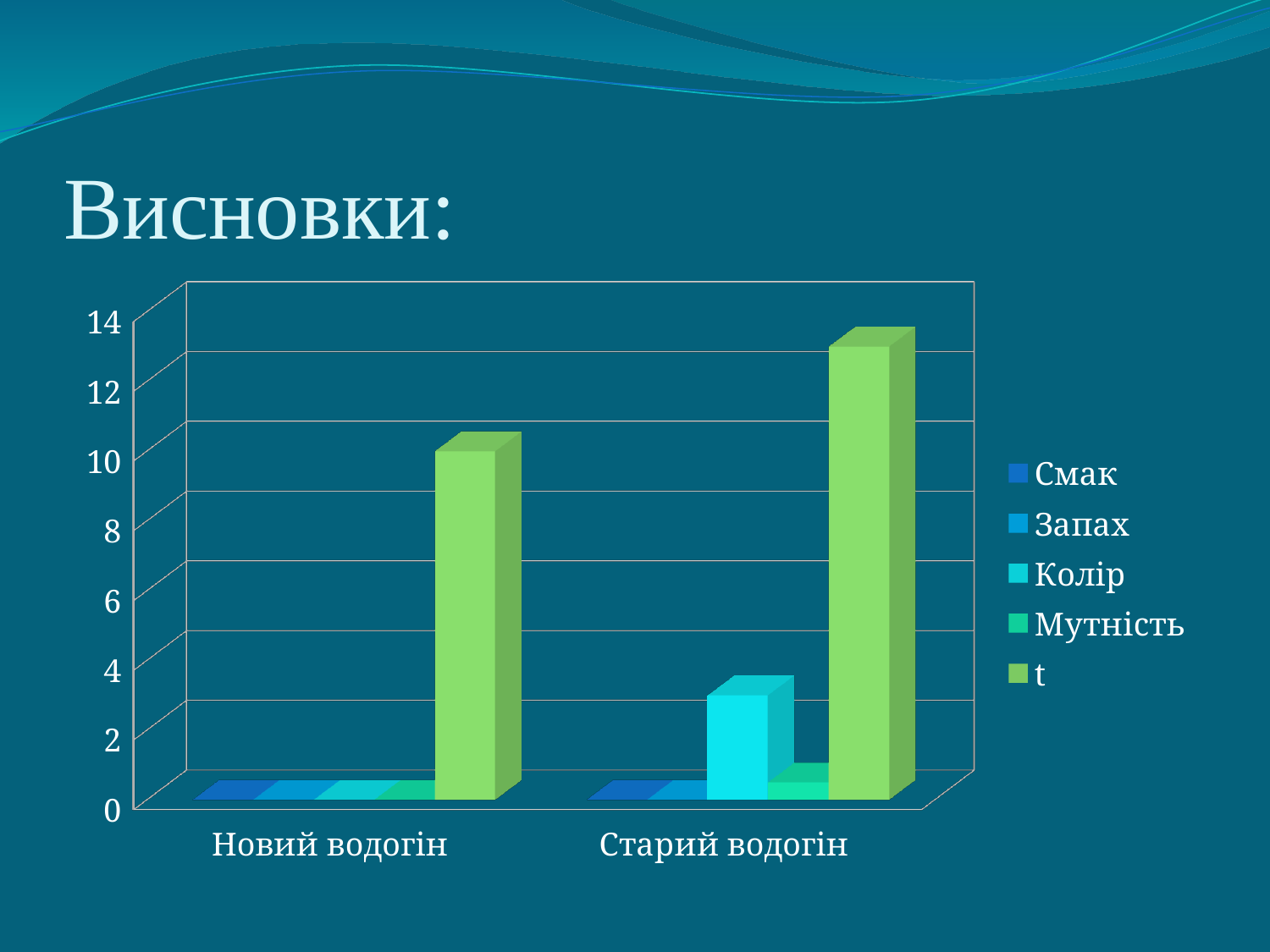
How many series does the chart's legend list? 5 How many categories are shown on the x axis of the chart? 2 Is the value of Колір for Старий водогін greater or less than 2? greater Which series has the highest value for Старий водогін? t Is the value of t for Старий водогін greater or less than 12? greater What kind of chart is shown on the slide? bar chart What is the title of the slide containing the chart? Висновки: Is the value of t for Новий водогін greater or less than 12? less Which category has the larger value for Колір, Новий водогін or Старий водогін? Старий водогін Which category has the larger value for t, Новий водогін or Старий водогін? Старий водогін Which series has the highest value for Новий водогін? t